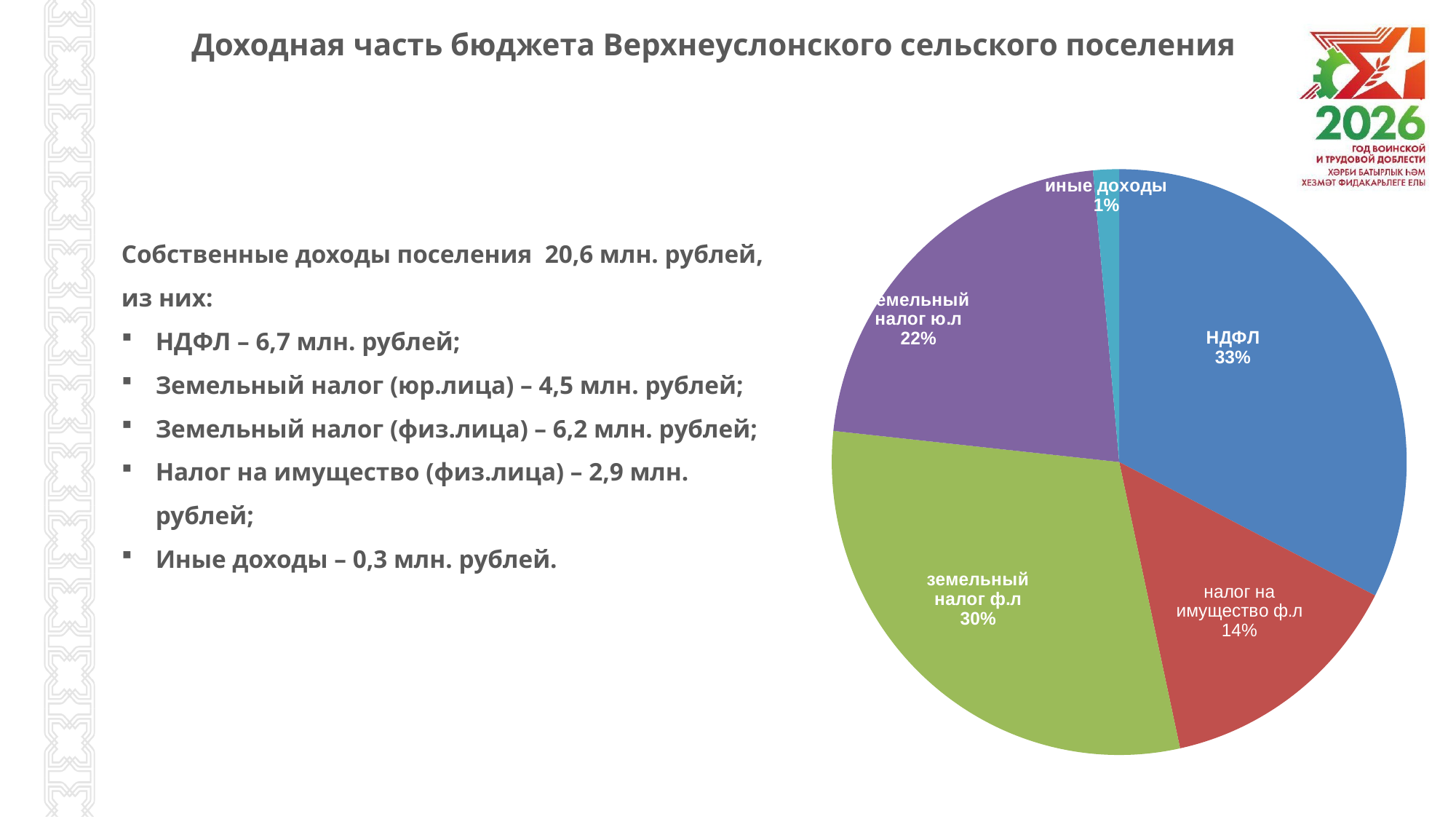
What share of the pie does земельный налог ю.л represent? 22% What kind of chart is shown on the slide? pie chart Which slice of the pie chart is the largest? НДФЛ What share of the pie does НДФЛ represent? 33% How many slices does the pie chart have? 5 What share of the pie does иные доходы represent? 1% What is the difference in percentage points between НДФЛ and налог на имущество ф.л? 19 What colour is the НДФЛ slice in the pie chart? blue Which is larger, the share for земельный налог ф.л or the share for земельный налог ю.л? земельный налог ф.л Which slice of the pie chart is the smallest? иные доходы